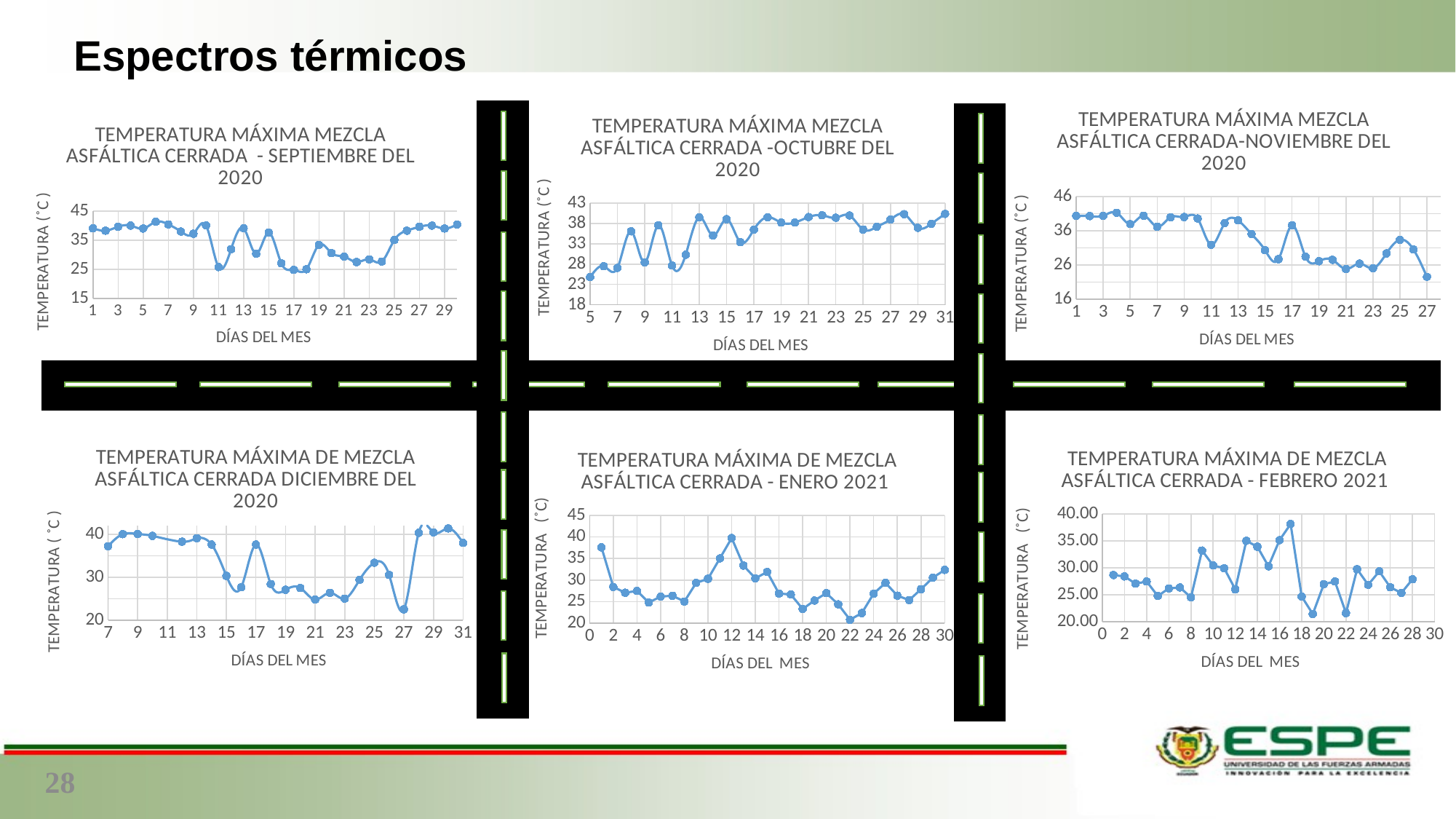
In the ENERO 2021 chart, is the value for day 12 greater or less than 35? greater In the SEPTIEMBRE DEL 2020 chart, is the value for day 11 greater or less than 35? less In the ENERO 2021 chart, is the value for day 22 greater or less than 25? less What kind of chart is the TEMPERATURA MÁXIMA MEZCLA ASFÁLTICA CERRADA - SEPTIEMBRE DEL 2020 chart? line chart In the OCTUBRE DEL 2020 chart, do the values overall rise or fall from day 5 to day 31? rise How many charts are shown on the slide? 6 What is the x-axis label of the SEPTIEMBRE DEL 2020 chart? DÍAS DEL MES In the NOVIEMBRE DEL 2020 chart, do the values overall rise or fall from day 1 to day 27? fall